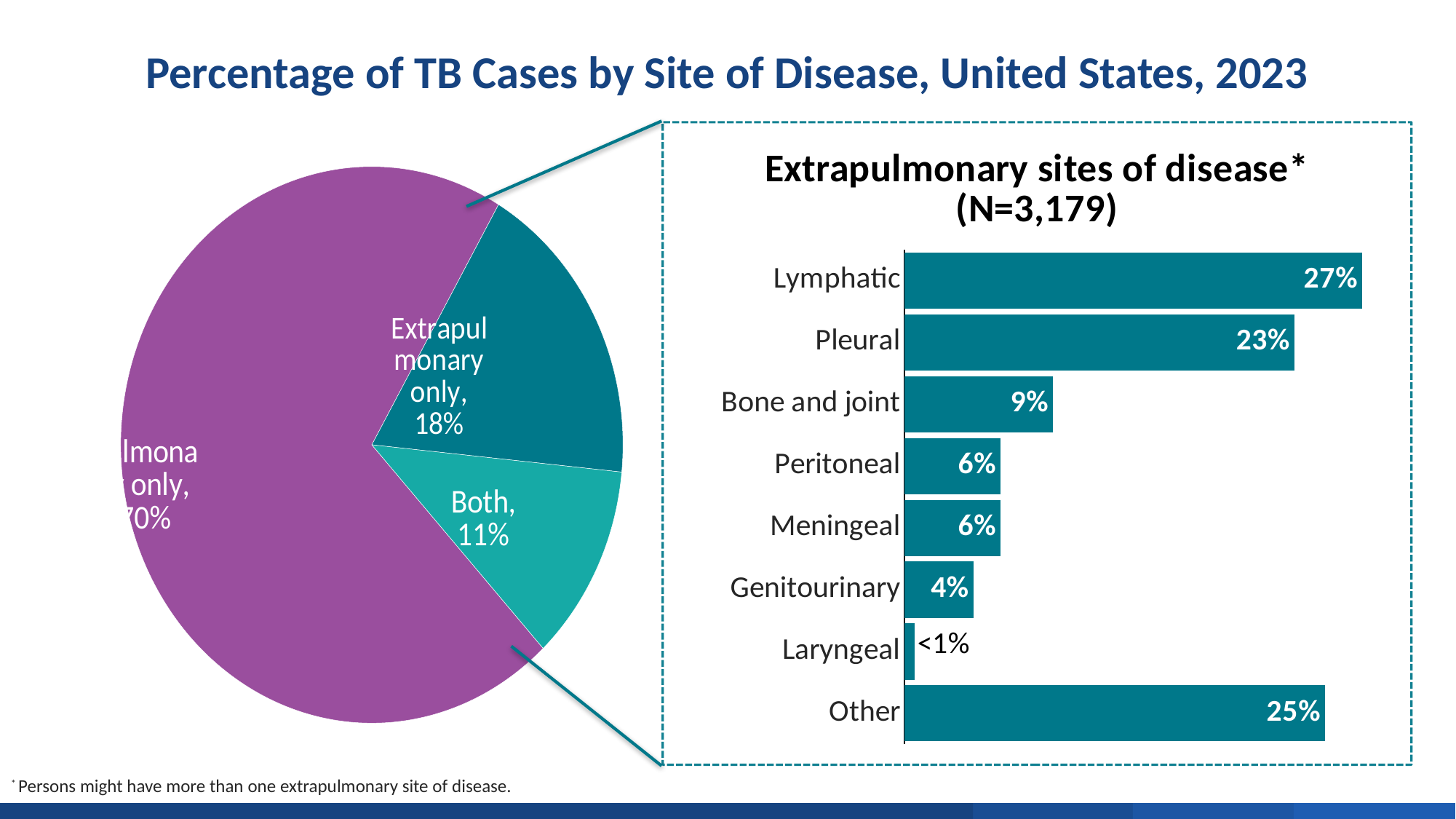
In the 'Extrapulmonary sites of disease' chart, which site has the lowest percentage? Laryngeal In the 'Extrapulmonary sites of disease' chart, what is the difference in percentage points between Lymphatic and Other? 2 In the 'Extrapulmonary sites of disease' chart, what is the value for Pleural? 23% In the 'Extrapulmonary sites of disease' chart, what is the value for Laryngeal? <1% In the 'Extrapulmonary sites of disease' chart, what is the value for Lymphatic? 27% What type of chart is the 'Extrapulmonary sites of disease' chart on the right? Bar chart In the pie chart on the left, what is the difference in percentage points between the 'Extrapulmonary only' slice and the 'Both' slice? 7 In the 'Extrapulmonary sites of disease' chart, which site has the highest percentage? Lymphatic In the pie chart on the left, what percentage of TB cases is labelled 'Extrapulmonary only'? 18% In the pie chart on the left, what percentage of TB cases is labelled 'Both'? 11% How many sites are listed in the 'Extrapulmonary sites of disease' chart? 8 In the pie chart on the left, which is larger, the 'Extrapulmonary only' slice or the 'Both' slice? Extrapulmonary only